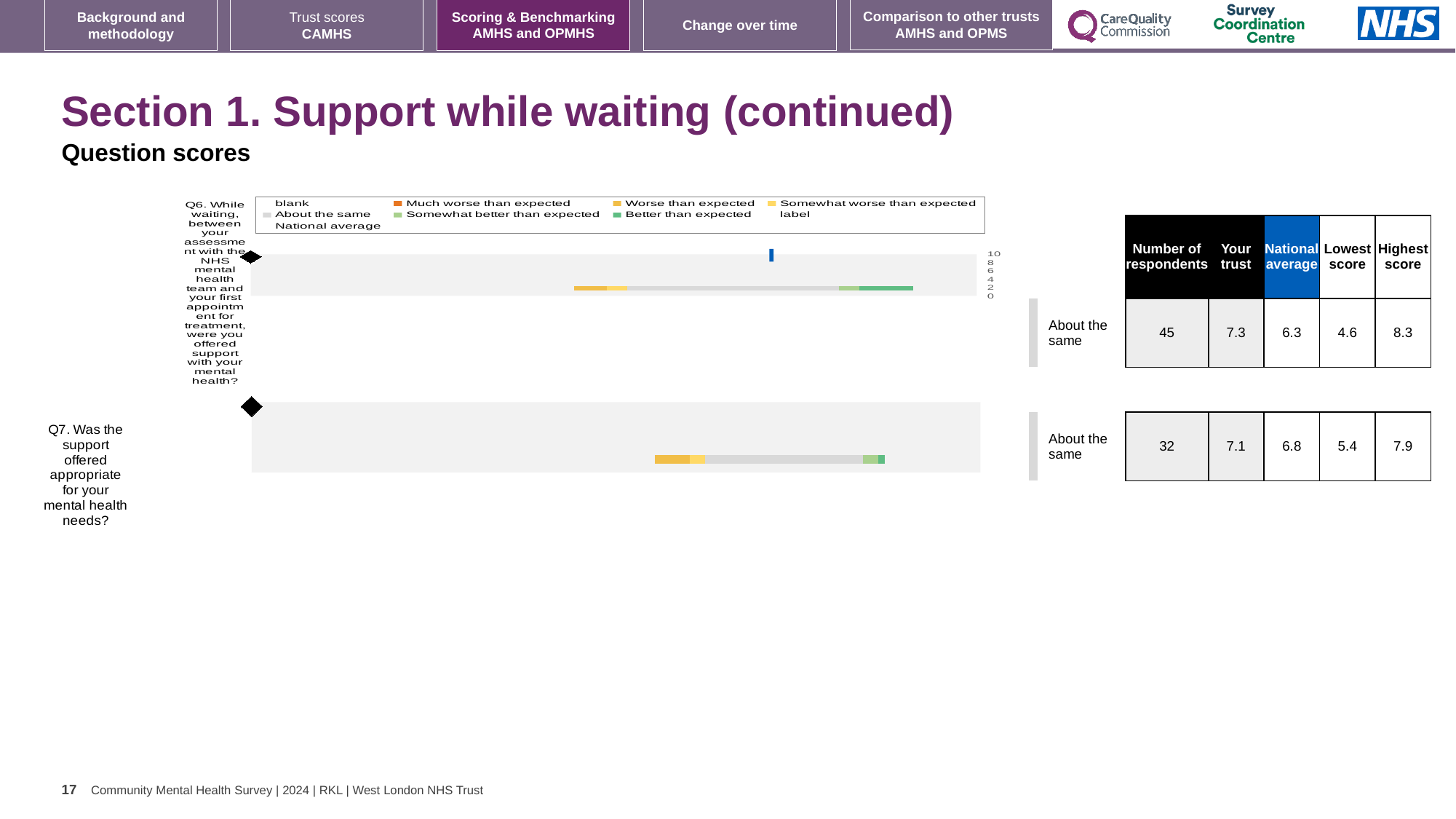
What is the lowest score shown for Q6? 4.6 What is the national average for Q7? 6.8 What benchmark category is given for Q7? About the same How many respondents answered Q6? 45 Which question has the higher 'Your trust' score, Q6 or Q7? Q6 What is the difference between the highest and lowest scores for Q7? 2.5 What is the difference between the trust score and the national average for Q6? 1.0 What kind of chart is shown on the slide? bar chart How many questions (categories) are plotted in the chart? 2 What is the highest score shown for Q7? 7.9 What is the 'Your trust' score for Q6? 7.3 What colour is the 'Better than expected' legend entry? green